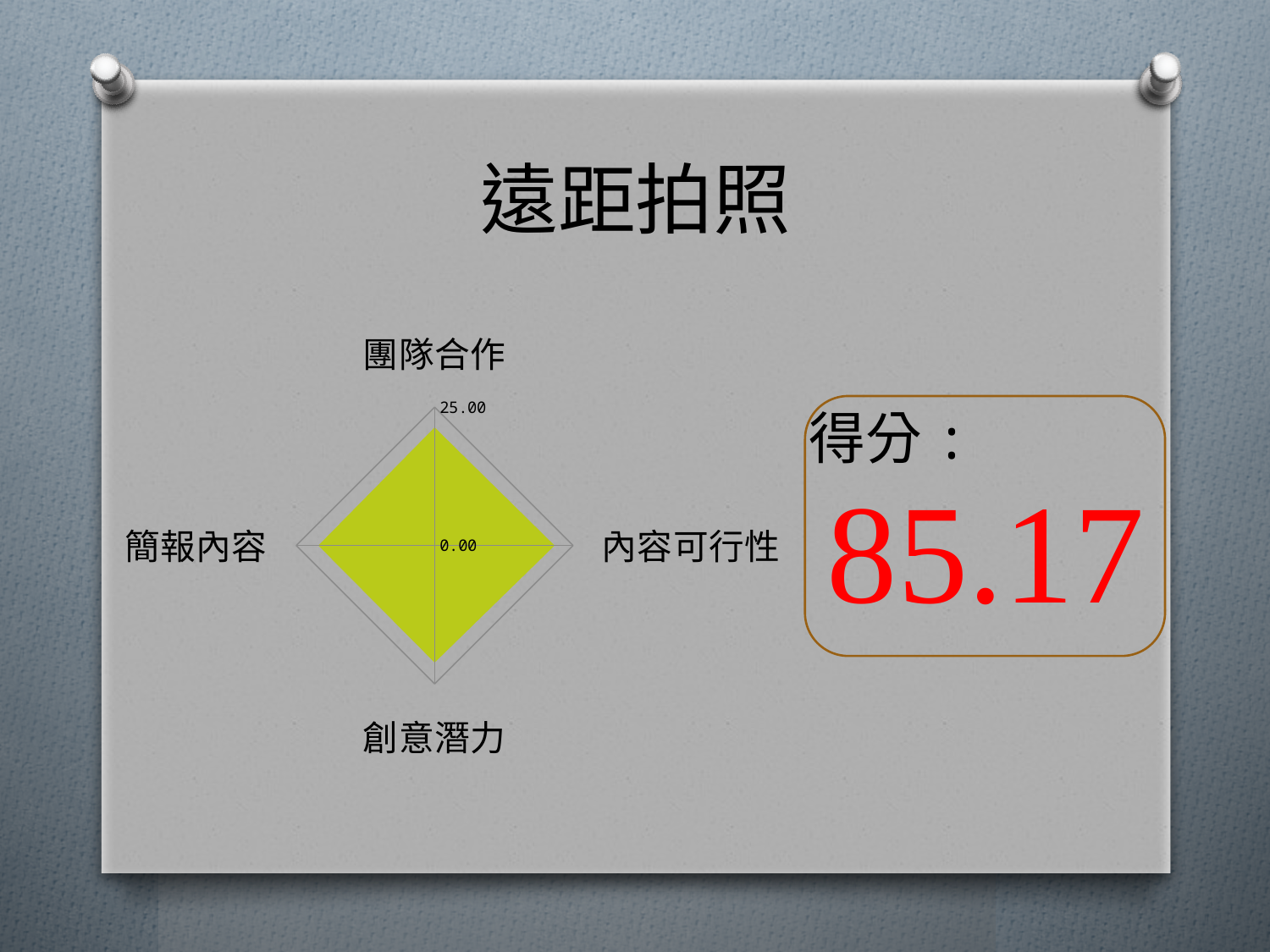
How many categories (axes) does the radar chart have? 4 What is the title of the slide containing the radar chart? 遠距拍照 What kind of chart is shown on the slide? radar chart Is the value for 團隊合作 on the radar chart greater or less than 0.00? greater Which category label appears at the top of the radar chart? 團隊合作 Is the value for 創意潛力 on the radar chart greater or less than 0.00? greater Which category label appears on the left side of the radar chart? 簡報內容 What is the maximum axis value printed on the radar chart? 25.00 Which category label appears at the bottom of the radar chart? 創意潛力 Which category label appears on the right side of the radar chart? 內容可行性